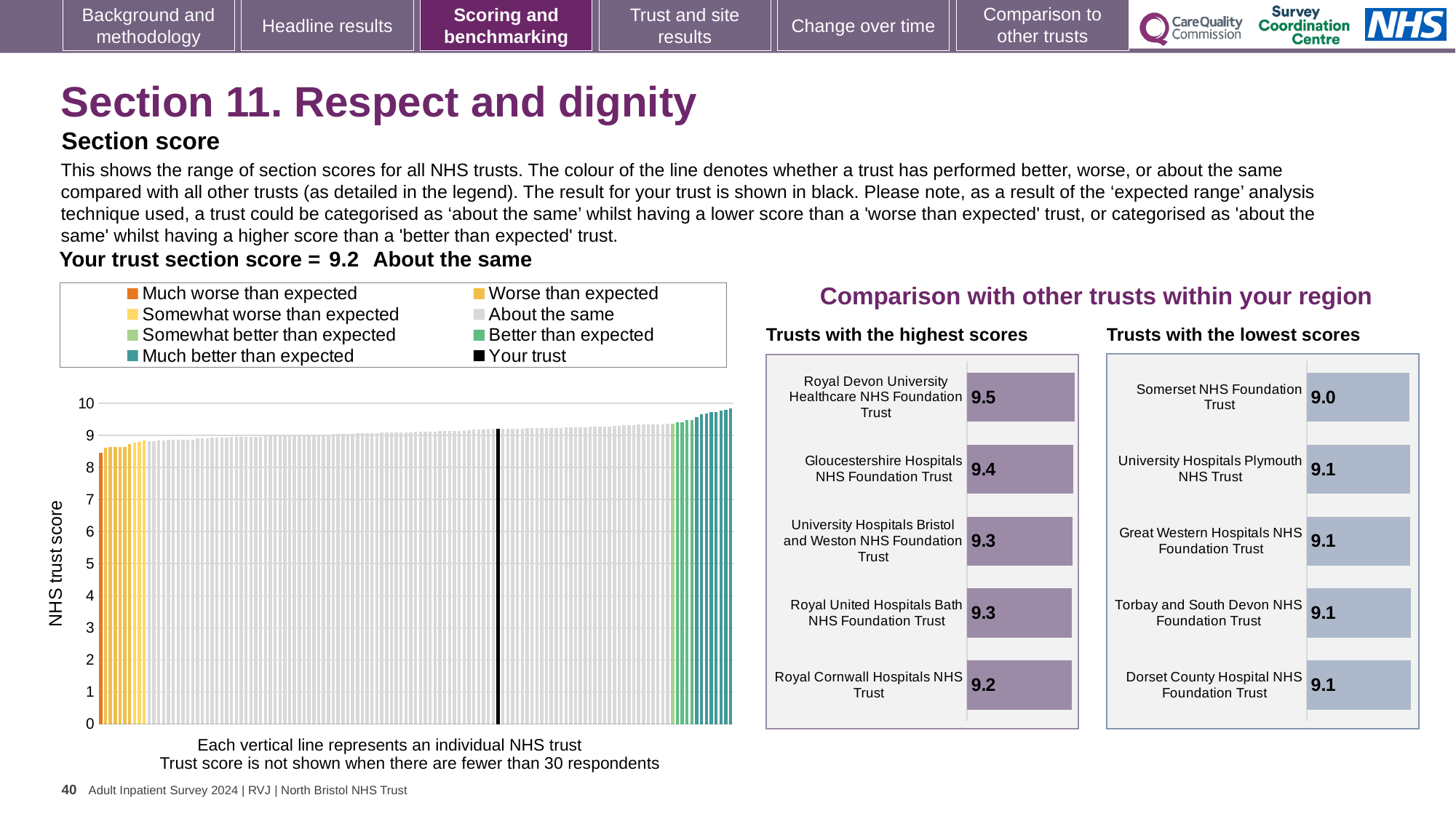
In the 'Trusts with the lowest scores' chart, which trust has the lowest score? Somerset NHS Foundation Trust Which is larger: the score for Gloucestershire Hospitals NHS Foundation Trust in the highest scores chart, or the score for Somerset NHS Foundation Trust in the lowest scores chart? Gloucestershire Hospitals NHS Foundation Trust How many trusts are shown in the 'Trusts with the highest scores' chart? 5 In the NHS trust score chart on the left, is the value for your trust (the black bar) greater or less than 9? greater In the 'Trusts with the lowest scores' chart, what is the score for Somerset NHS Foundation Trust? 9.0 In the 'Trusts with the highest scores' chart, which trust has the highest score? Royal Devon University Healthcare NHS Foundation Trust In the 'Trusts with the highest scores' chart, what is the difference between the scores of Royal Devon University Healthcare NHS Foundation Trust and Royal Cornwall Hospitals NHS Trust? 0.3 What kind of chart is the 'NHS trust score' chart on the left of the slide? Bar chart In the 'Trusts with the highest scores' chart, what is the score for Gloucestershire Hospitals NHS Foundation Trust? 9.4 In the 'Trusts with the lowest scores' chart, what is the score for Dorset County Hospital NHS Foundation Trust? 9.1 How many entries does the legend of the NHS trust score chart on the left list? 8 In the 'Trusts with the highest scores' chart, what is the score for Royal Devon University Healthcare NHS Foundation Trust? 9.5